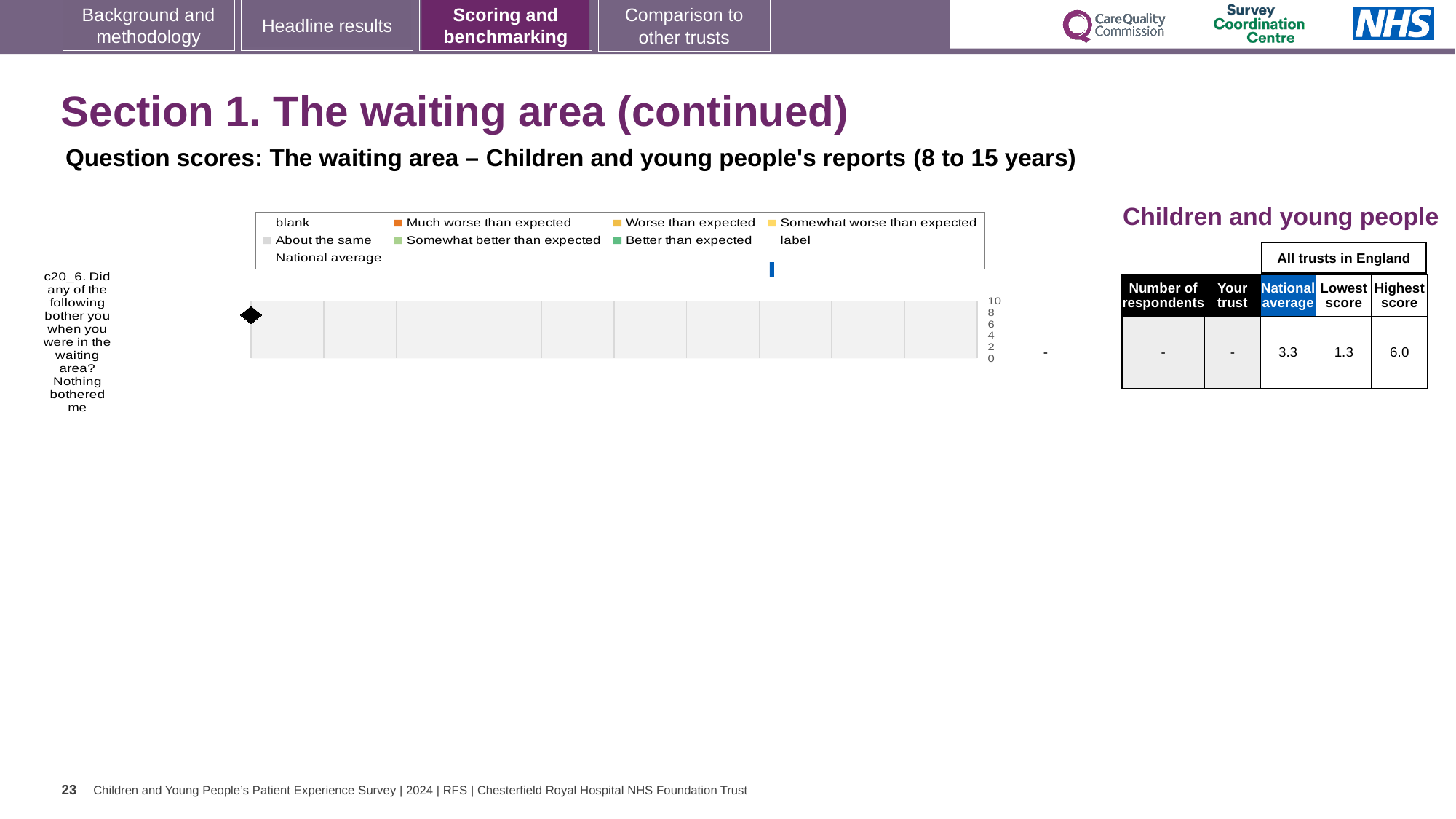
Which is larger in the table, the national average or the lowest score? National average What value is shown for 'Your trust' in the table? - In the table, what is the lowest score across all trusts in England for question c20_6? 1.3 What is the difference between the highest score and the lowest score in the table? 4.7 What value is shown for 'Number of respondents' in the table? - What kind of chart is shown on the slide? bar chart Is the national average score in the table greater or less than 4? less In the table, what is the national average score for question c20_6? 3.3 How many question categories are plotted on the chart? 1 Which legend entry is shown with an orange marker? Much worse than expected In the table, what is the highest score across all trusts in England for question c20_6? 6.0 What is the highest value shown on the chart's axis? 10